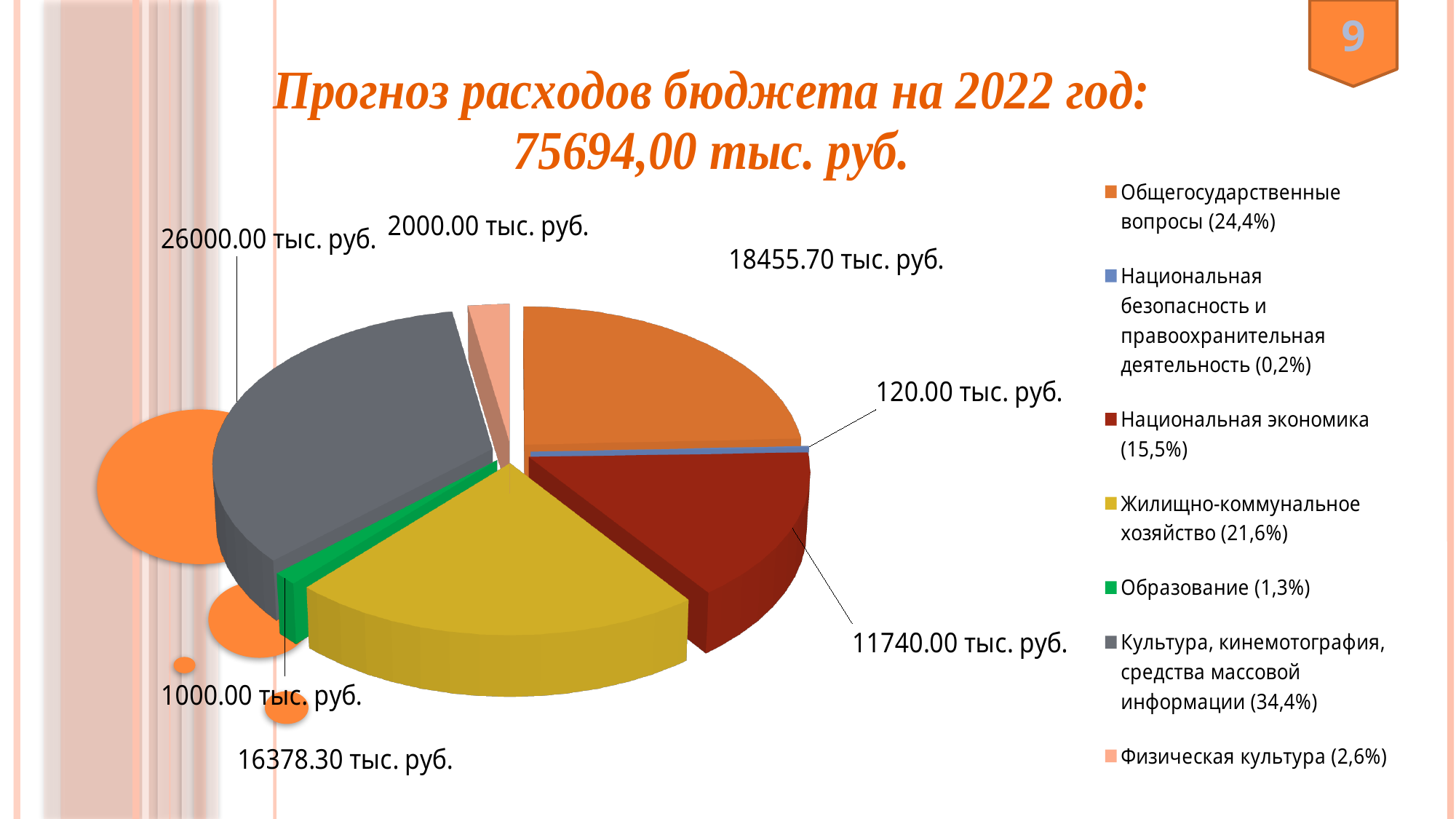
What share of the pie does Жилищно-коммунальное хозяйство represent? 21,6% What is the value for Образование? 1000.00 тыс. руб. Which is larger, the value for Физическая культура or the value for Образование? Физическая культура How many categories does the pie chart show? 7 Which category has the largest slice of the pie? Культура, кинемотография, средства массовой информации What is the title of the chart? Прогноз расходов бюджета на 2022 год: 75694,00 тыс. руб. Which category has the smallest slice of the pie? Национальная безопасность и правоохранительная деятельность What is the value for Жилищно-коммунальное хозяйство? 16378.30 тыс. руб. What is the value for Национальная экономика? 11740.00 тыс. руб. What is the value for Общегосударственные вопросы? 18455.70 тыс. руб. What is the difference between the values for Культура, кинемотография, средства массовой информации and Общегосударственные вопросы? 7544.30 тыс. руб. What kind of chart is shown on the slide? pie chart